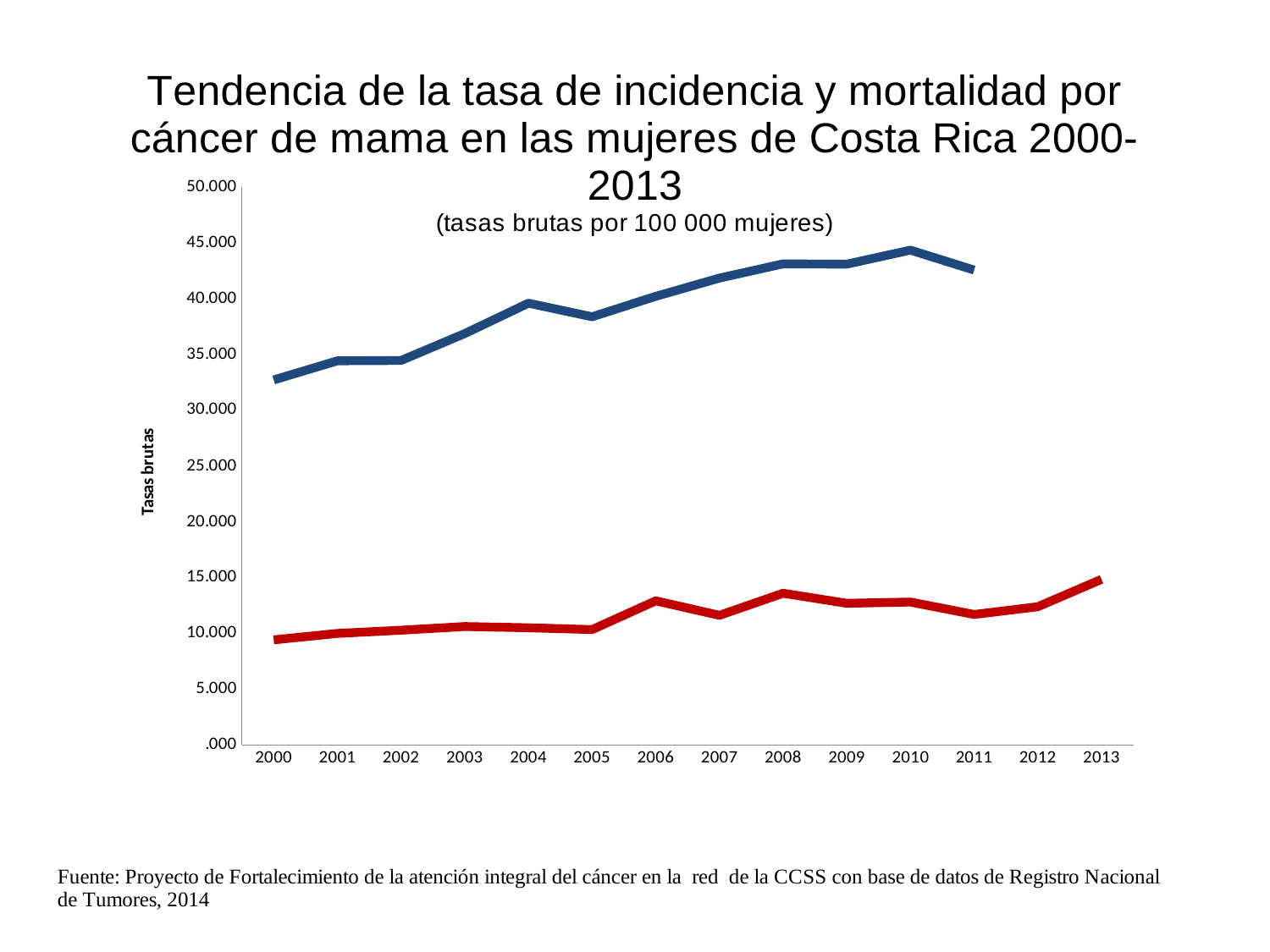
What is the label on the vertical axis of the chart? Tasas brutas Is the value of the blue line for 2000 greater or less than 30.000? greater Is the value of the red line for 2006 greater or less than 10.000? greater Is the value of the blue line for 2005 greater or less than 40.000? less What kind of chart is shown on the slide? line chart In which year does the red line reach its highest value? 2013 How many lines are plotted on the chart? 2 In which year does the blue line reach its highest value? 2010 How many years are labelled on the x axis of the chart? 14 In 2005, which line has the larger value, the blue line or the red line? the blue line